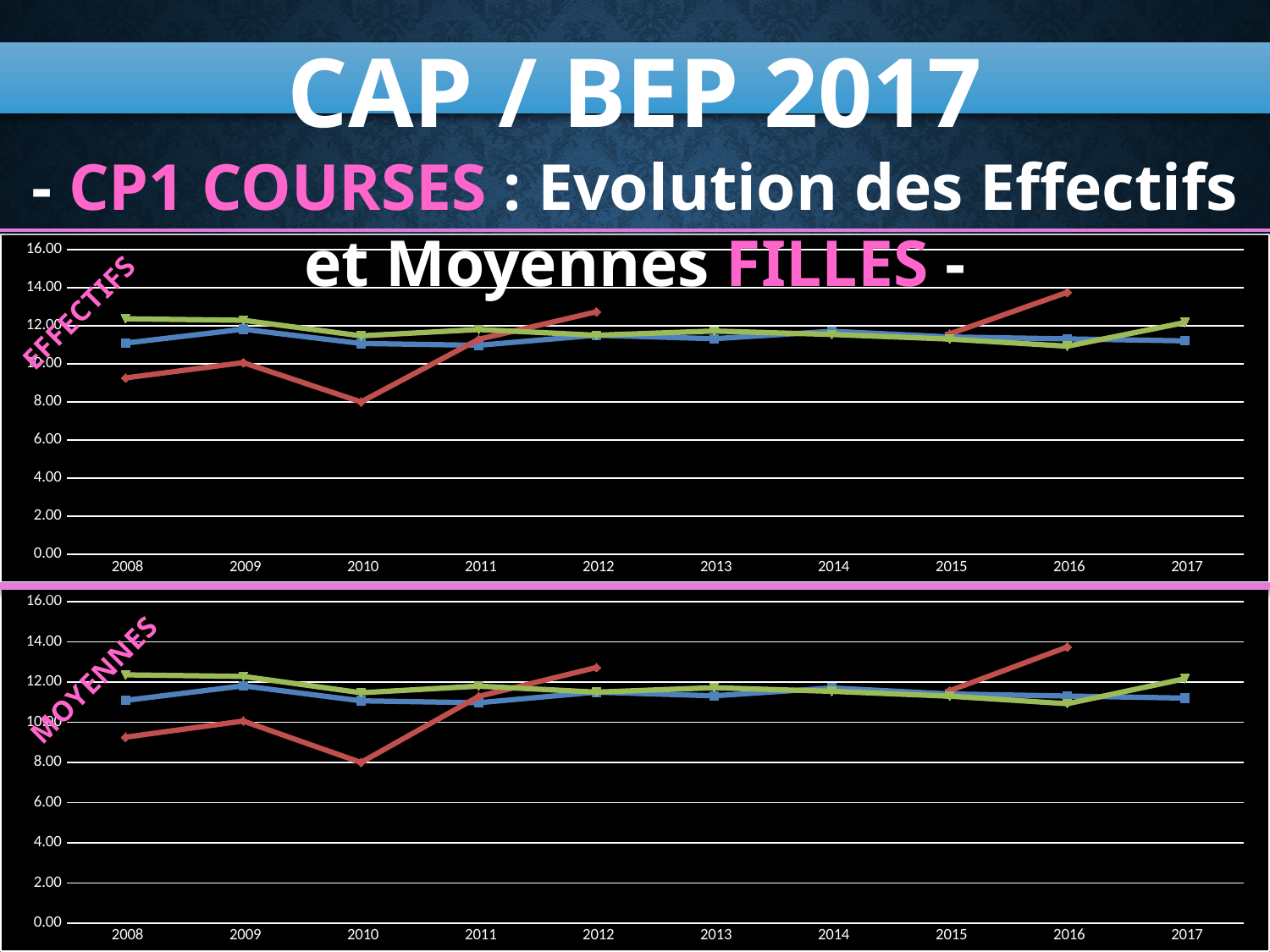
In the bottom chart (MOYENNES), is the value of the green line for 2008 greater or less than 12.00? greater In the top chart (EFFECTIFS), in which year does the red line reach its highest point? 2016 In the top chart (EFFECTIFS), does the red line rise or fall from 2010 to 2012? rise In the top chart (EFFECTIFS), which line is higher in 2010, the red line or the green line? green line In the top chart (EFFECTIFS), is the value of the red line for 2016 greater or less than 12.00? greater In the bottom chart (MOYENNES), which line is higher in 2016, the red line or the blue line? red line In the bottom chart (MOYENNES), what is the highest value shown on the y axis? 16.00 In the top chart (EFFECTIFS), in which year does the red line reach its lowest point? 2010 In the top chart (EFFECTIFS), is the value of the red line for 2010 greater or less than 10.00? less In the top chart (EFFECTIFS), what is the first year on the x axis? 2008 What kind of chart is the top chart labelled EFFECTIFS? line chart In the top chart (EFFECTIFS), how many years are shown on the x axis? 10